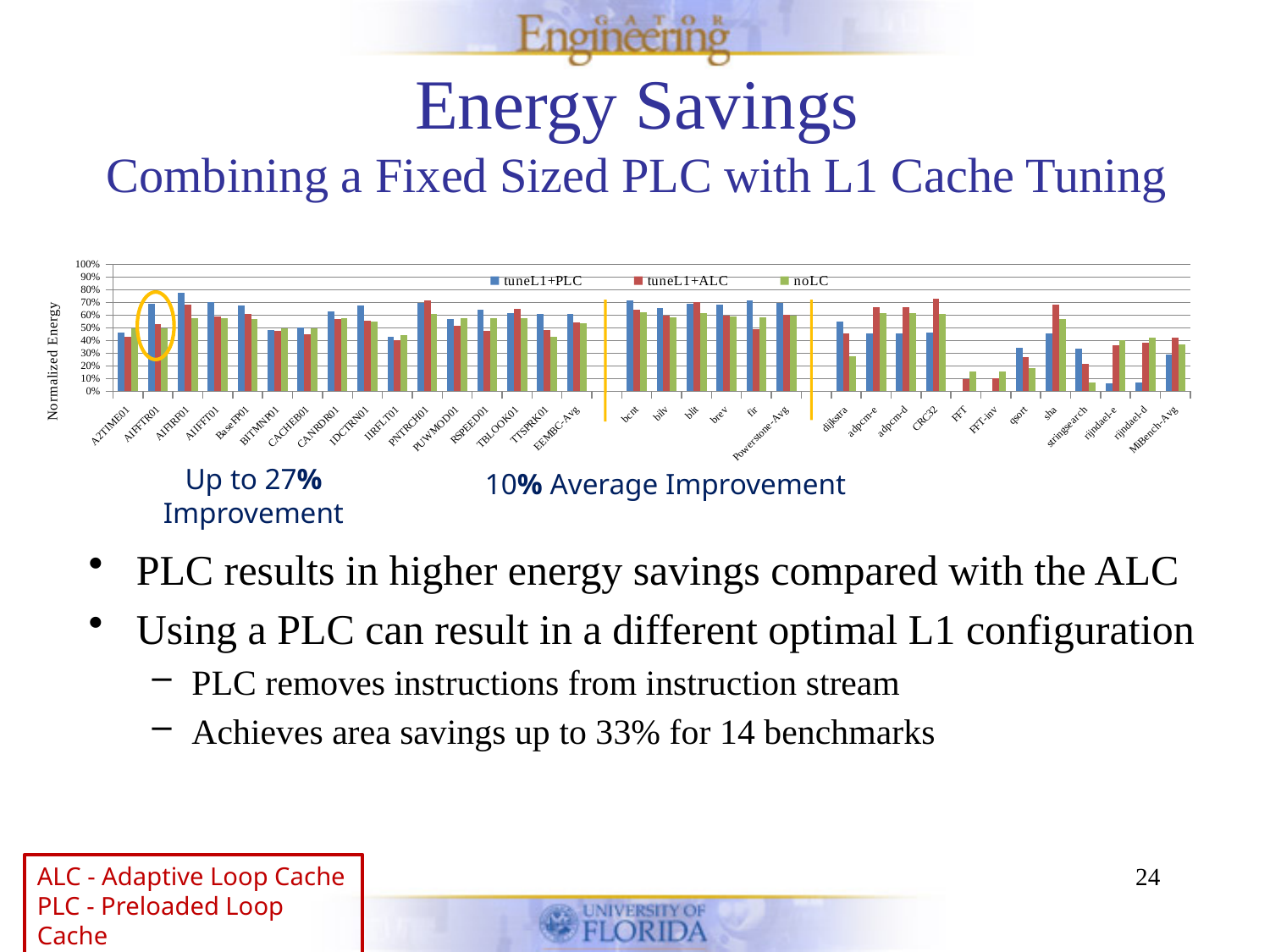
What is the title of the chart's vertical axis? Normalized Energy For dijkstra, which series has the highest bar? tuneL1+PLC What are the three series named in the chart legend? tuneL1+PLC, tuneL1+ALC, noLC Is the tuneL1+ALC value for sha greater or less than 50%? greater For sha, which is larger: the tuneL1+PLC value or the tuneL1+ALC value? tuneL1+ALC For CRC32, which is larger: the tuneL1+PLC value or the tuneL1+ALC value? tuneL1+ALC What kind of chart is shown on the slide? bar chart How many series does the chart's legend list? 3 For rijndael-e, which series has the lowest bar? tuneL1+PLC Is the tuneL1+PLC value for AIFIRF01 greater or less than 60%? greater Is the tuneL1+PLC value for rijndael-e greater or less than 20%? less